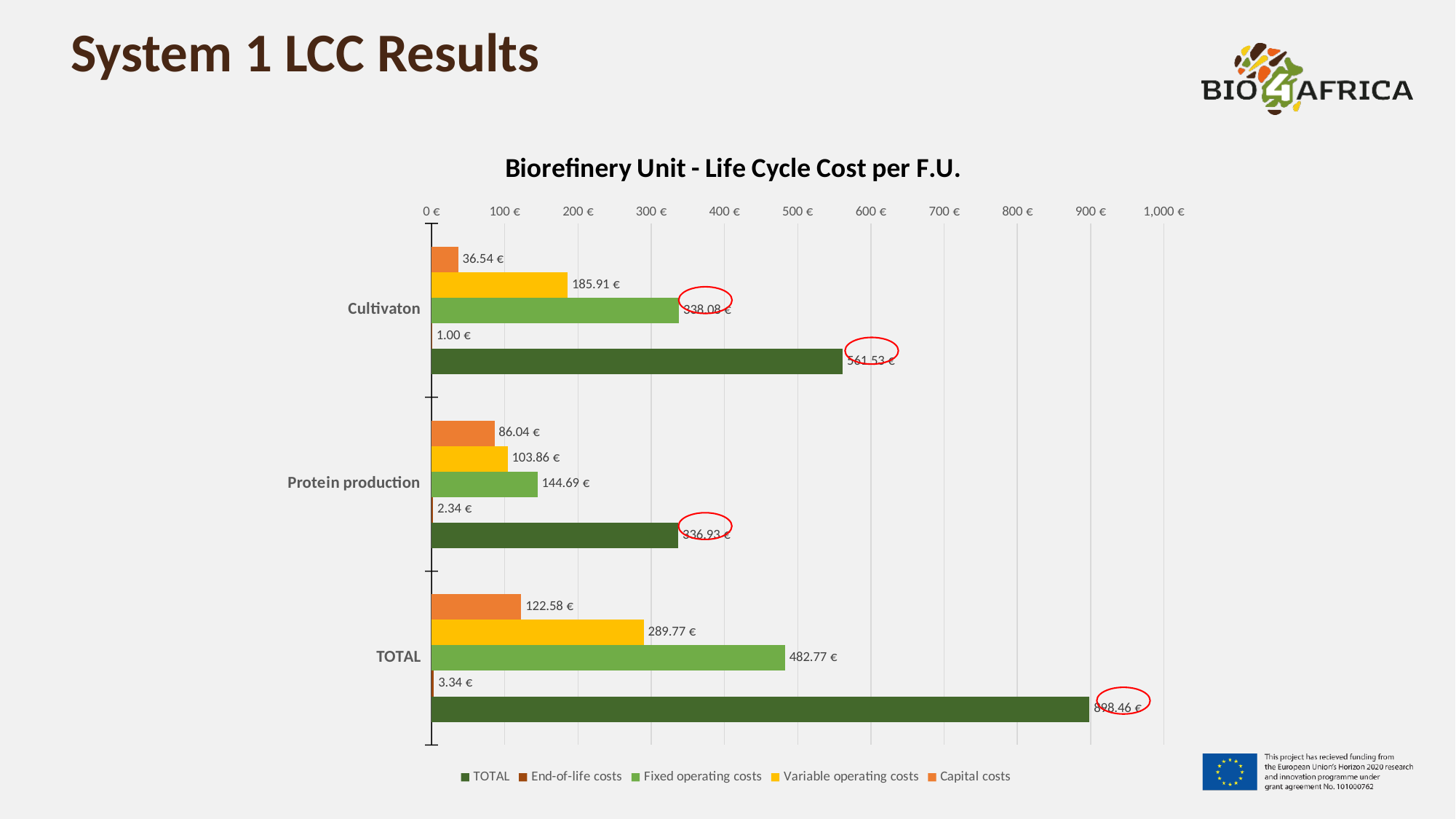
How many categories are shown on the vertical axis? 3 What is the Capital costs value for Cultivaton? 36.54 € What is the Fixed operating costs value for the TOTAL category? 482.77 € What is the Variable operating costs value for Protein production? 103.86 € Which category has the highest Capital costs? TOTAL Is the TOTAL series value for the TOTAL category greater or less than 800 €? greater Which is larger for Protein production: Capital costs or Variable operating costs? Variable operating costs How many series does the legend list? 5 What is the difference between the Variable operating costs for Cultivaton and for Protein production? 82.05 € Which category has the lowest End-of-life costs? Cultivaton What type of chart is shown on the slide? Bar chart What is the End-of-life costs value for Protein production? 2.34 €